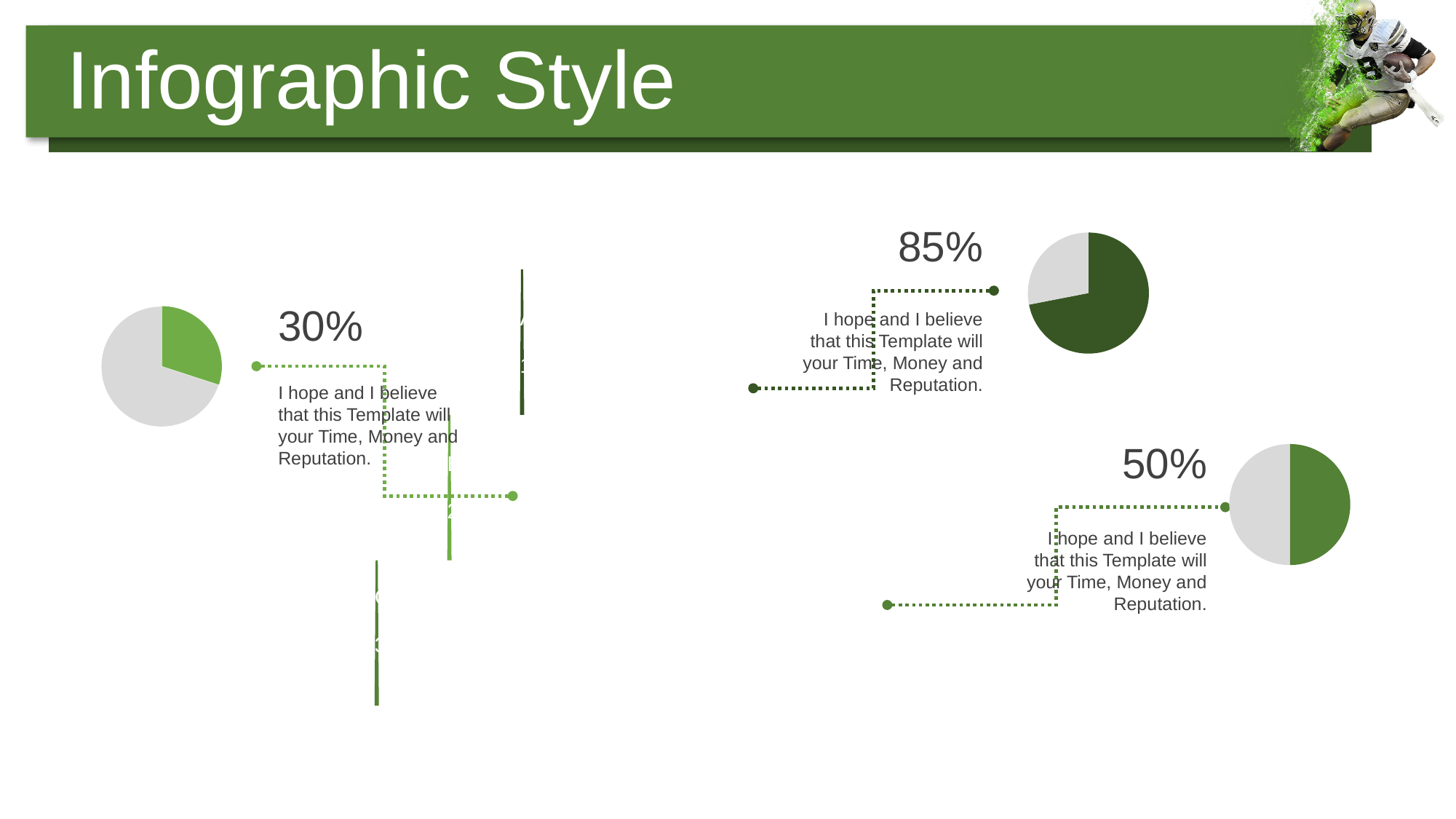
Which pie chart on the slide shows the lowest percentage? the left pie chart (30%) What kind of chart is shown on the left side of the slide next to the 30% label? pie chart What colour is the filled slice of the upper right pie chart? dark green How many pie charts are on the slide? 3 What is the difference between the percentage shown for the upper right pie chart and the lower right pie chart? 35% What percentage is shown next to the pie chart in the lower right of the slide? 50% Which is larger, the percentage for the lower right pie chart or the left pie chart? the lower right pie chart (50%) Which pie chart on the slide shows the highest percentage? the upper right pie chart (85%) What is the difference between the percentage shown for the upper right pie chart and the left pie chart? 55% What is the title of the slide containing the pie charts? Infographic Style What percentage is shown next to the pie chart in the upper right of the slide? 85% What percentage is shown next to the pie chart on the left side of the slide? 30%